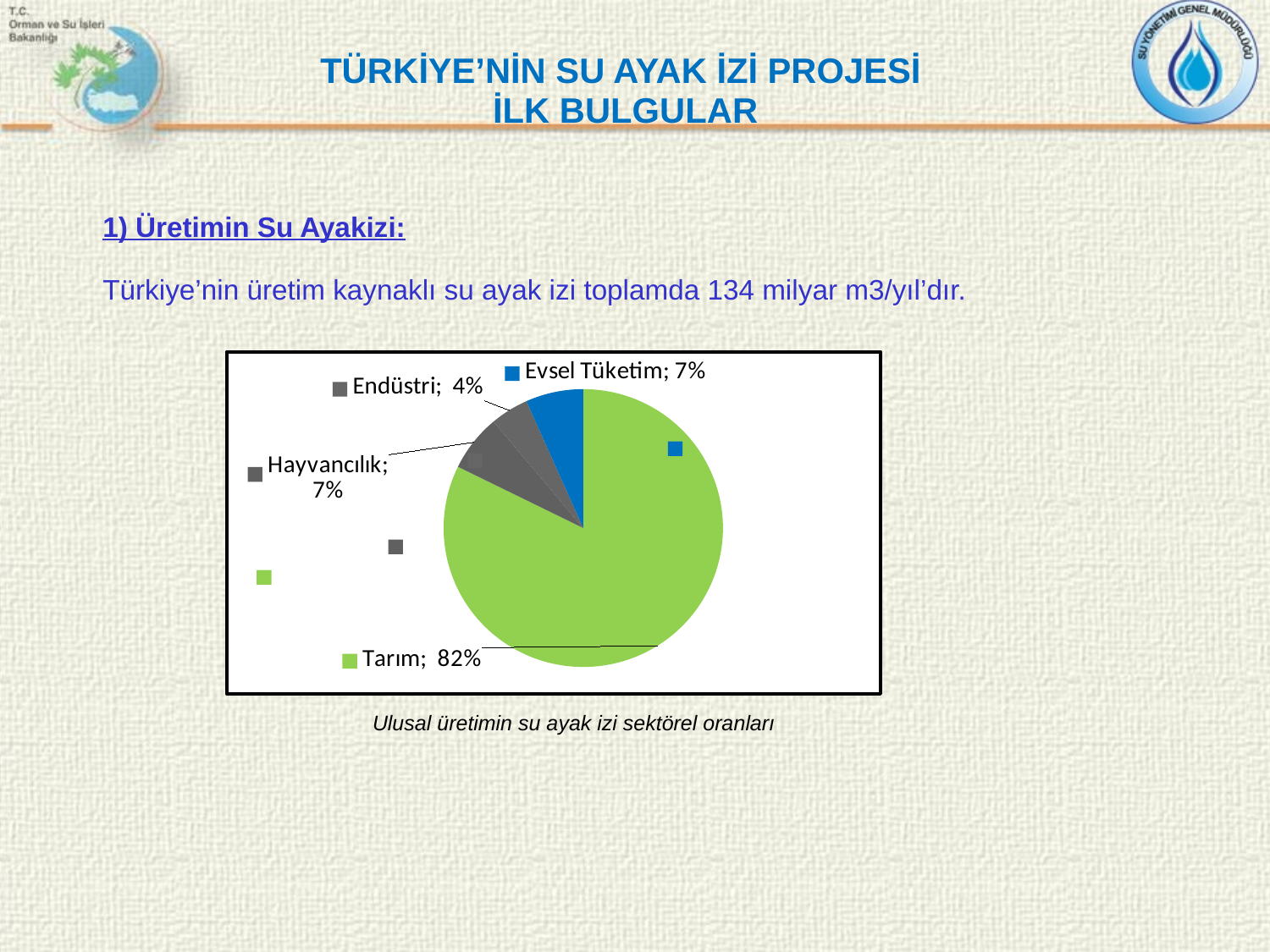
Which sector has the largest slice of the pie? Tarım What is the caption written below the pie chart? Ulusal üretimin su ayak izi sektörel oranları What type of chart is shown on the slide? pie chart Which is larger, the share for Endüstri or the share for Evsel Tüketim? Evsel Tüketim What is the difference in percentage points between Evsel Tüketim and Endüstri? 3 What is the value shown for Evsel Tüketim? 7% What share of the pie does Tarım account for? 82% What is the difference in percentage points between Tarım and Hayvancılık? 75 How many slices does the pie chart have? 4 Which sector has the smallest slice of the pie? Endüstri What is the value shown for Endüstri? 4% What is the value shown for Hayvancılık? 7%